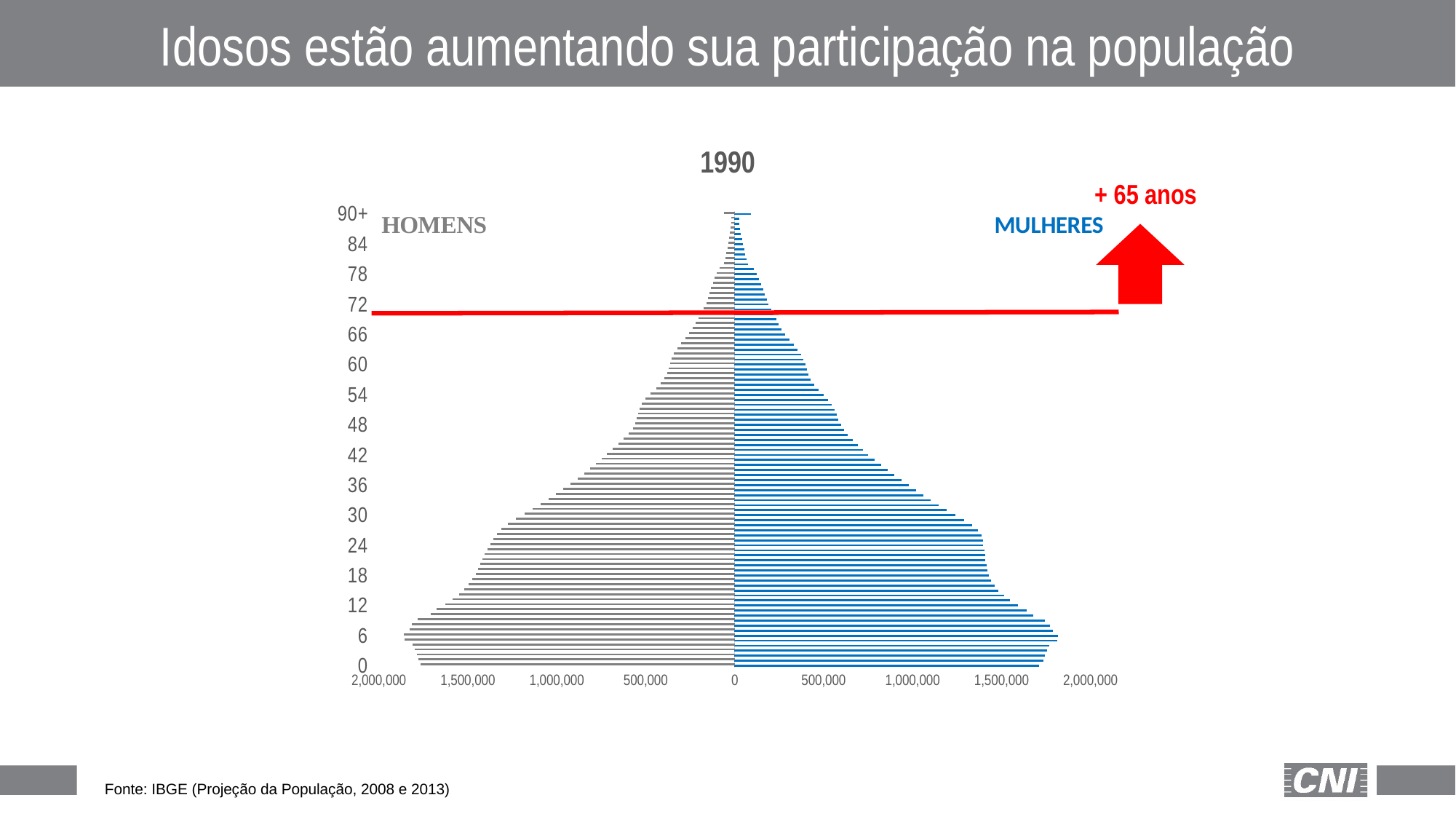
Do the bar lengths for HOMENS generally rise or fall as age increases from 6 to 90+? fall What is the title of the chart? 1990 Is the value for MULHERES at age 30 greater or less than 1,000,000? greater Is the value for MULHERES at age 84 greater or less than 500,000? less Is the value for MULHERES at age 6 greater or less than 1,500,000? greater What kind of chart is shown on the slide? bar chart Which colour represents MULHERES in the chart? blue Which age group has the longest bar for MULHERES, 6 or 66? 6 How many series does the chart show? 2